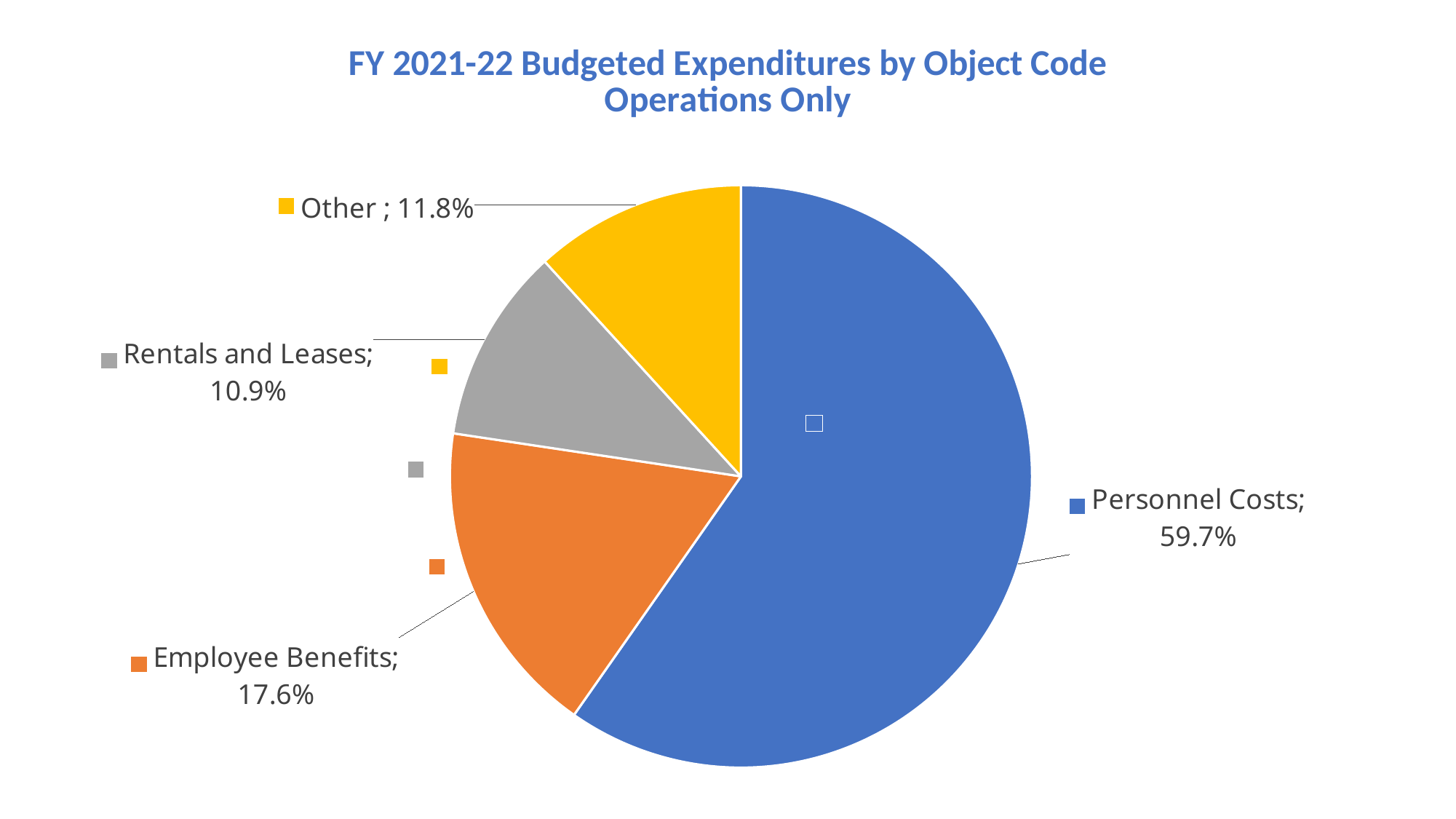
What share of budgeted expenditures is Employee Benefits? 17.6% What share of budgeted expenditures is Personnel Costs? 59.7% What is the difference in percentage points between Other and Rentals and Leases? 0.9 What share of budgeted expenditures is Rentals and Leases? 10.9% What kind of chart is shown on the slide? Pie chart How many categories are shown in the pie chart? 4 Which category has the smallest share of the pie? Rentals and Leases Which is larger, the share for Employee Benefits or the share for Other? Employee Benefits What is the title of the chart? FY 2021-22 Budgeted Expenditures by Object Code Operations Only What share of budgeted expenditures is Other? 11.8% Which category has the largest share of the pie? Personnel Costs What is the difference in percentage points between Personnel Costs and Employee Benefits? 42.1